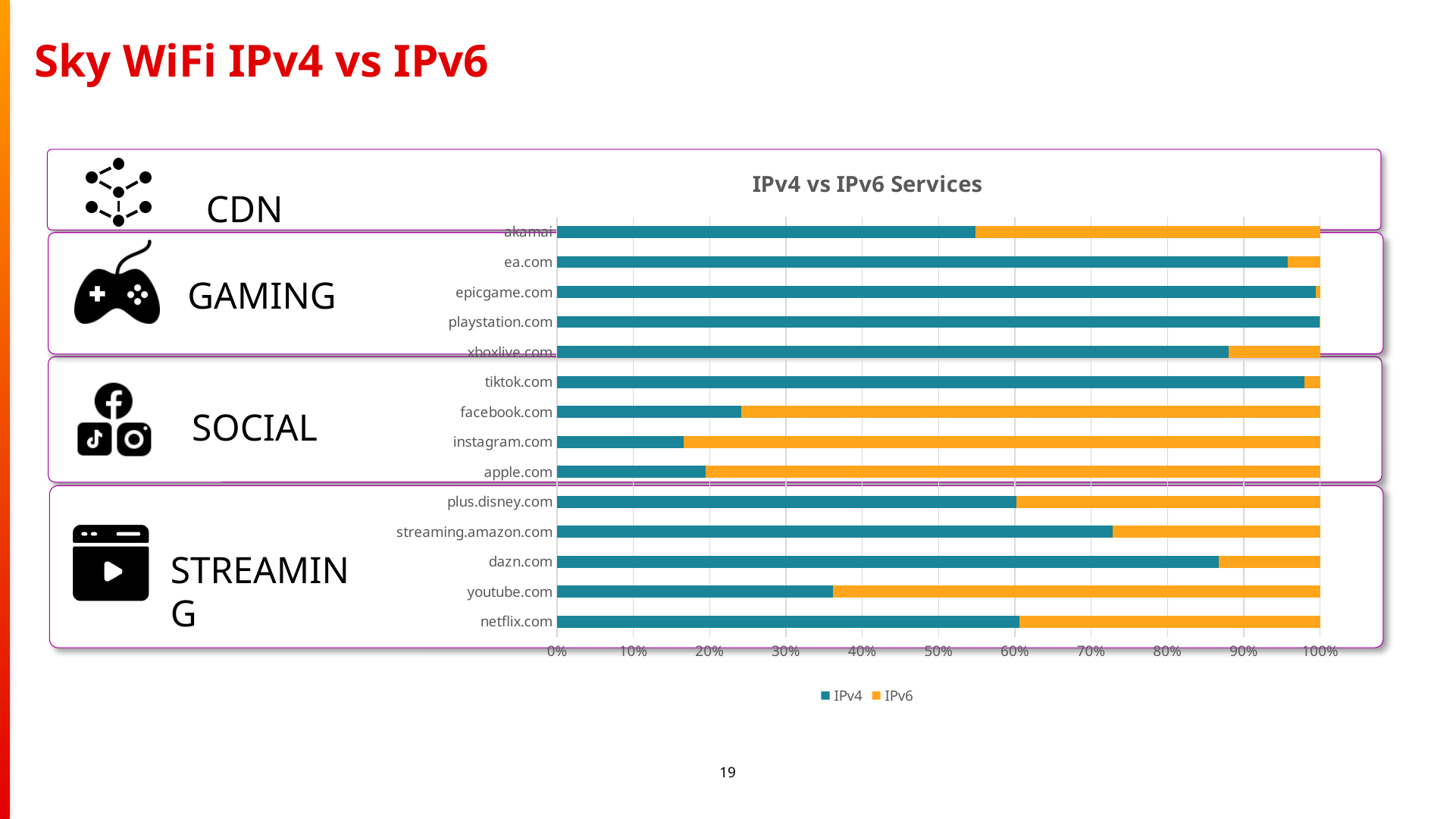
How many services (categories) are plotted in the IPv4 vs IPv6 Services chart? 14 Is the IPv4 share for akamai greater or less than 50%? greater How many series does the legend of the IPv4 vs IPv6 Services chart list? 2 What is the title of the chart? IPv4 vs IPv6 Services Which service has the highest IPv4 share in the chart? playstation.com Which service has the lowest IPv4 share in the chart? instagram.com Is the IPv4 share for dazn.com greater or less than 80%? greater Which has the larger IPv6 share, instagram.com or tiktok.com? instagram.com Is the IPv4 share for facebook.com greater or less than 30%? less Which has the larger IPv4 share, facebook.com or youtube.com? youtube.com What are the two series named in the legend of the chart? IPv4 and IPv6 What kind of chart is shown on the slide? Stacked bar chart